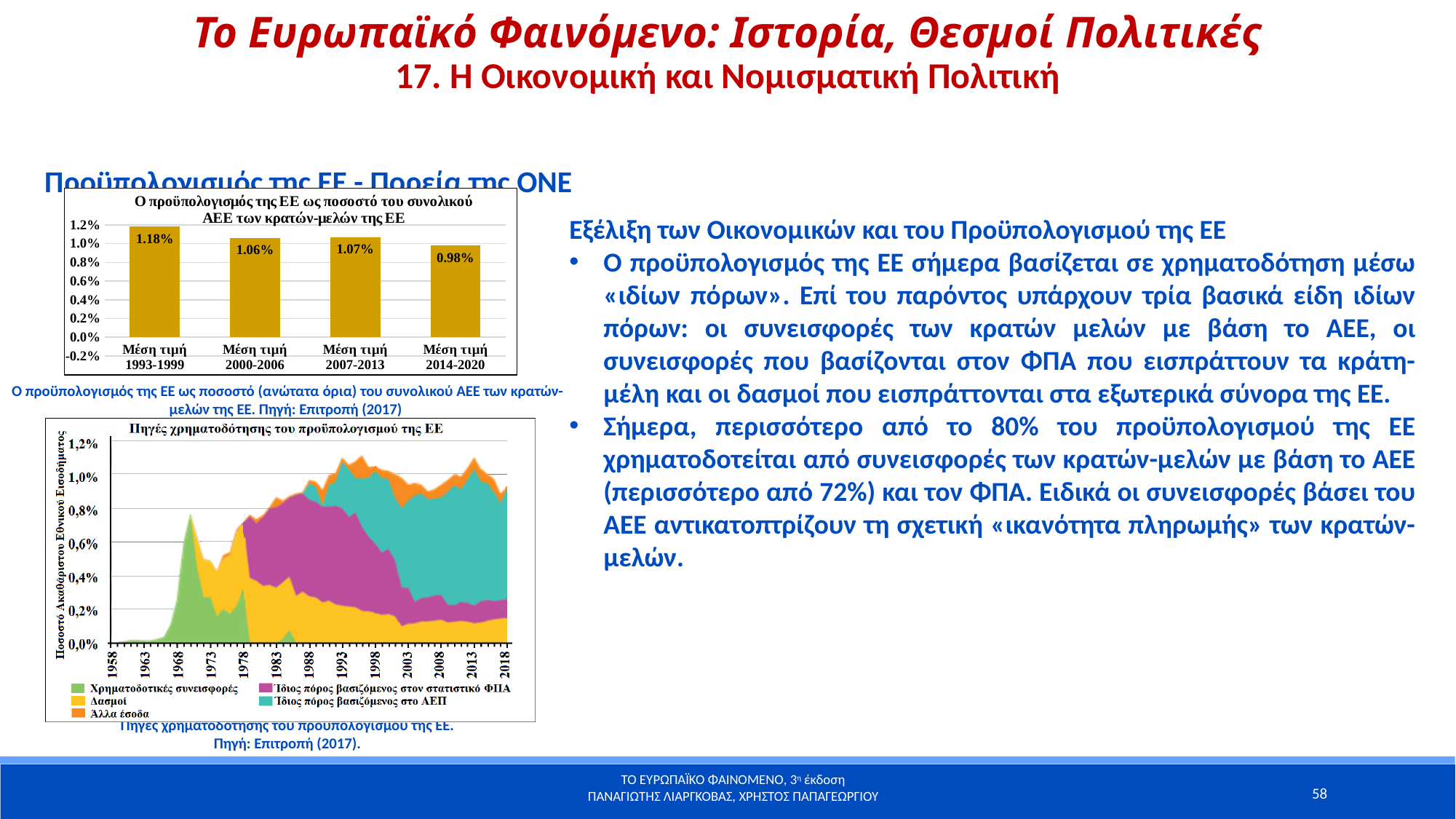
In the top bar chart, which period has the lowest value? Μέση τιμή 2014-2020 In the top bar chart, is the value for Μέση τιμή 2014-2020 greater or less than 1.0%? less In the top bar chart, what is the difference between the values for 1993-1999 and 2014-2020? 0.20% In the top bar chart, what is the value for Μέση τιμή 1993-1999? 1.18% How many bars are shown in the top chart? 4 In the top bar chart, which period has the highest value? Μέση τιμή 1993-1999 In the bottom chart, which colour represents Δασμοί in the legend? yellow What kind of chart is the bottom chart on the slide? stacked area chart In the top bar chart, what is the value for Μέση τιμή 2014-2020? 0.98% What kind of chart is the top chart on the slide? bar chart How many series does the legend of the bottom chart (Πηγές χρηματοδότησης του προϋπολογισμού της ΕΕ) list? 5 In the top bar chart, which is larger: the value for 2000-2006 or for 2007-2013? 2007-2013